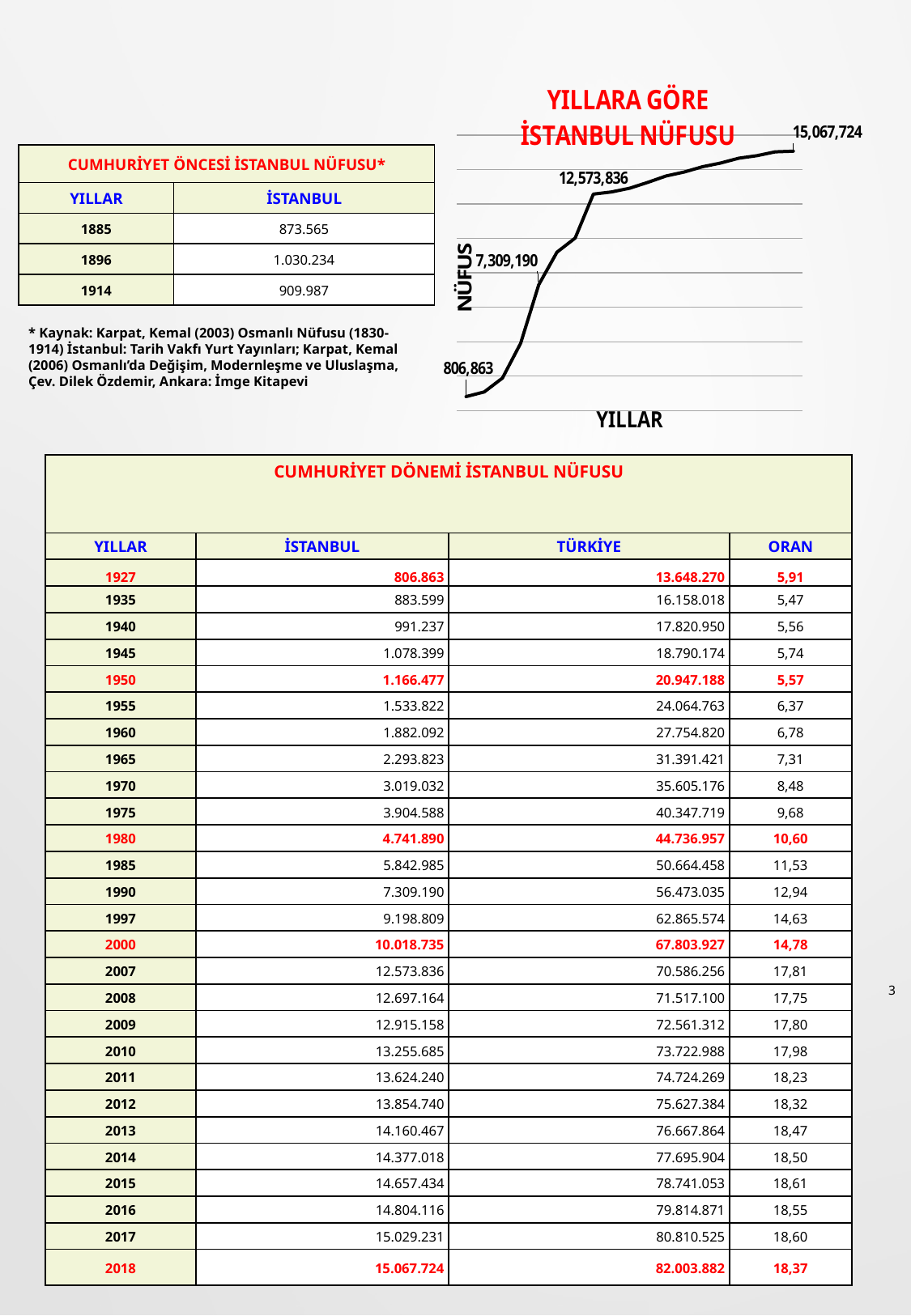
What is the label of the vertical axis of the chart? NÜFUS Do the values in the chart rise or fall from left to right along the x axis? rise What is the data label on the first (leftmost) point of the line in the chart? 806,863 What is the title of the chart on the slide? YILLARA GÖRE İSTANBUL NÜFUSU What is the highest value labeled on the chart? 15,067,724 What is the lowest value labeled on the chart? 806,863 What is the difference between the last labeled value (15,067,724) and the first labeled value (806,863) in the chart? 14,260,861 What is the difference between the labeled values 12,573,836 and 7,309,190 in the chart? 5,264,646 How many data labels are printed on the line in the chart? 4 What is the data label on the last (rightmost) point of the line in the chart? 15,067,724 What kind of chart is shown on the slide? line chart Which labeled value in the chart is larger, 12,573,836 or 7,309,190? 12,573,836